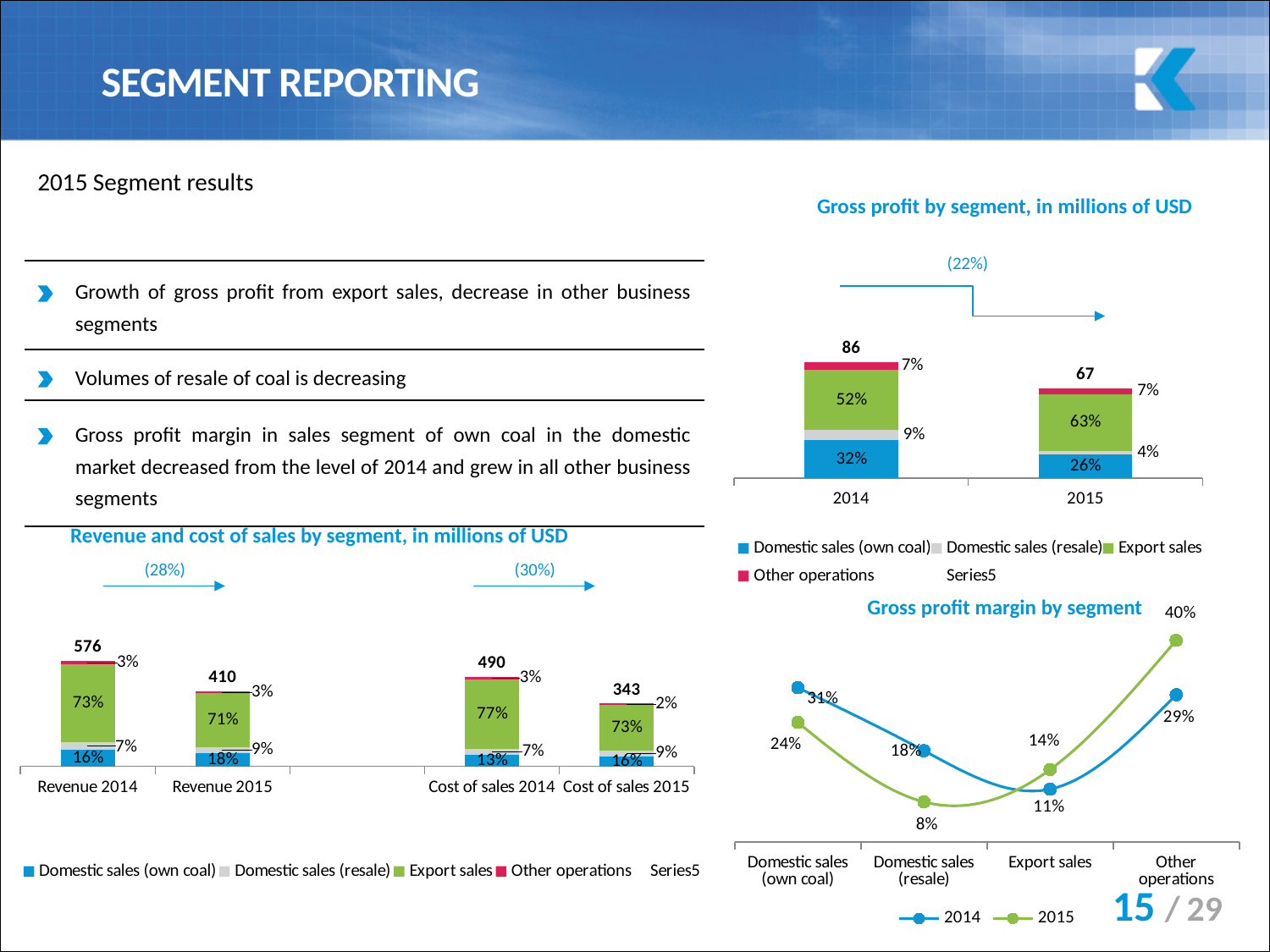
In the 'Gross profit margin by segment' chart, which segment has the lowest 2015 value? Domestic sales (resale) In the 'Revenue and cost of sales by segment, in millions of USD' chart, what is the difference between the Revenue 2014 total and the Cost of sales 2014 total? 86 What kind of chart is 'Gross profit margin by segment'? line chart In the 'Gross profit by segment, in millions of USD' chart, what is the difference between the 2014 and 2015 totals? 19 In the 'Gross profit margin by segment' chart, what is the 2015 value for Other operations? 40% In the 'Revenue and cost of sales by segment, in millions of USD' chart, which bar has the highest total? Revenue 2014 In the 'Gross profit by segment, in millions of USD' chart, what is the total gross profit shown for 2014? 86 In the 'Revenue and cost of sales by segment, in millions of USD' chart, what is the total for Revenue 2015? 410 In the 'Gross profit by segment, in millions of USD' chart, what share does Export sales have in 2015? 63% In the 'Gross profit margin by segment' chart, what is the 2014 value for Export sales? 11% In the 'Revenue and cost of sales by segment, in millions of USD' chart, what is the total for Cost of sales 2014? 490 In the 'Gross profit by segment, in millions of USD' chart, is the Domestic sales (own coal) share larger in 2014 or in 2015? 2014